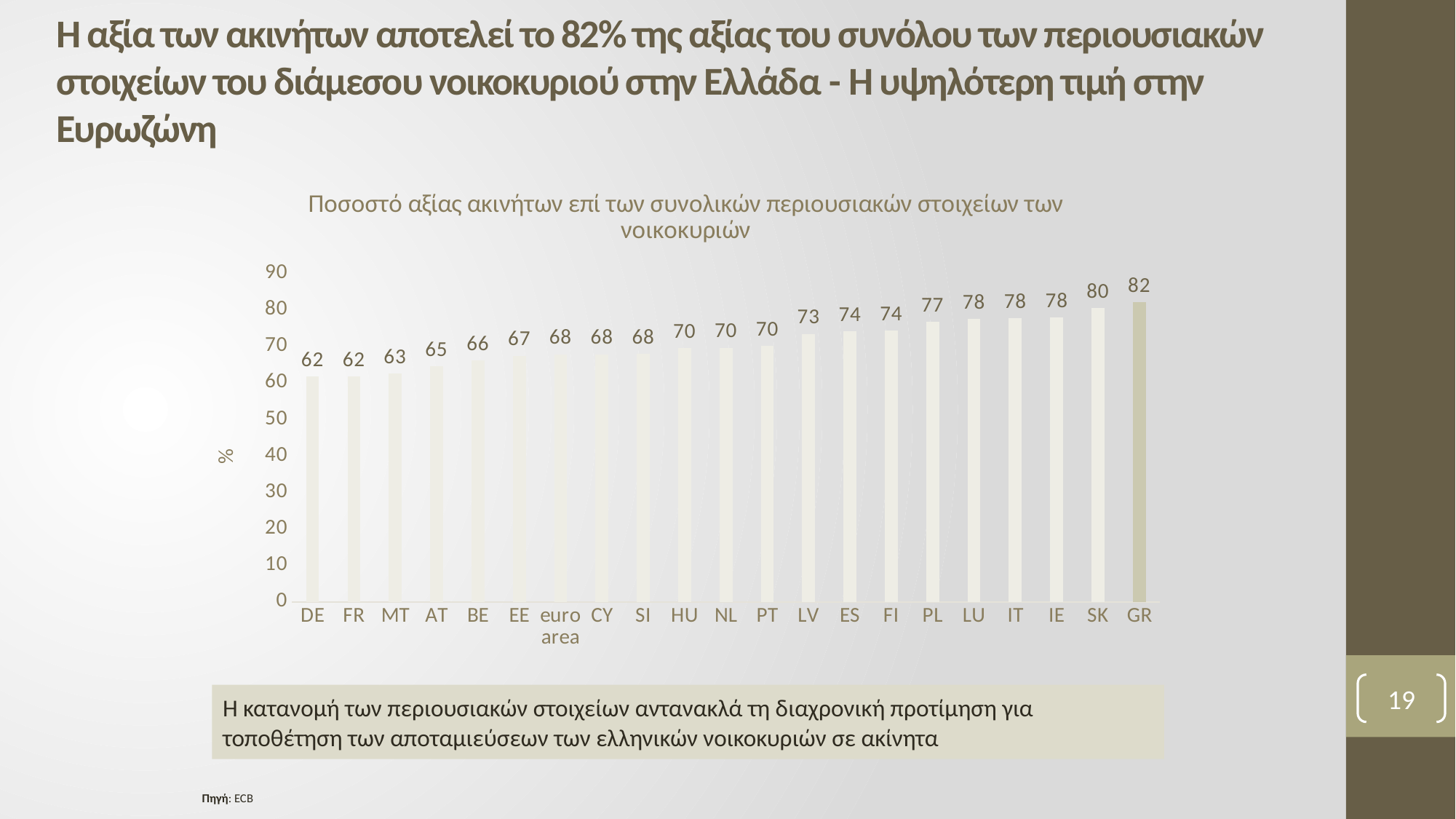
Which has a larger value, PL or ES? PL How many categories are shown on the x axis? 21 What is the value for GR? 82 Do the values rise or fall from left to right along the x axis? rise What kind of chart is shown on the slide? bar chart What is the lowest value shown in the chart? 62 What is the value for the euro area? 68 What is the difference between the values for SK and the euro area? 12 Which category has the highest value? GR What is the value for LV? 73 What is the difference between the values for GR and DE? 20 Is the value for HU greater or less than 60? greater